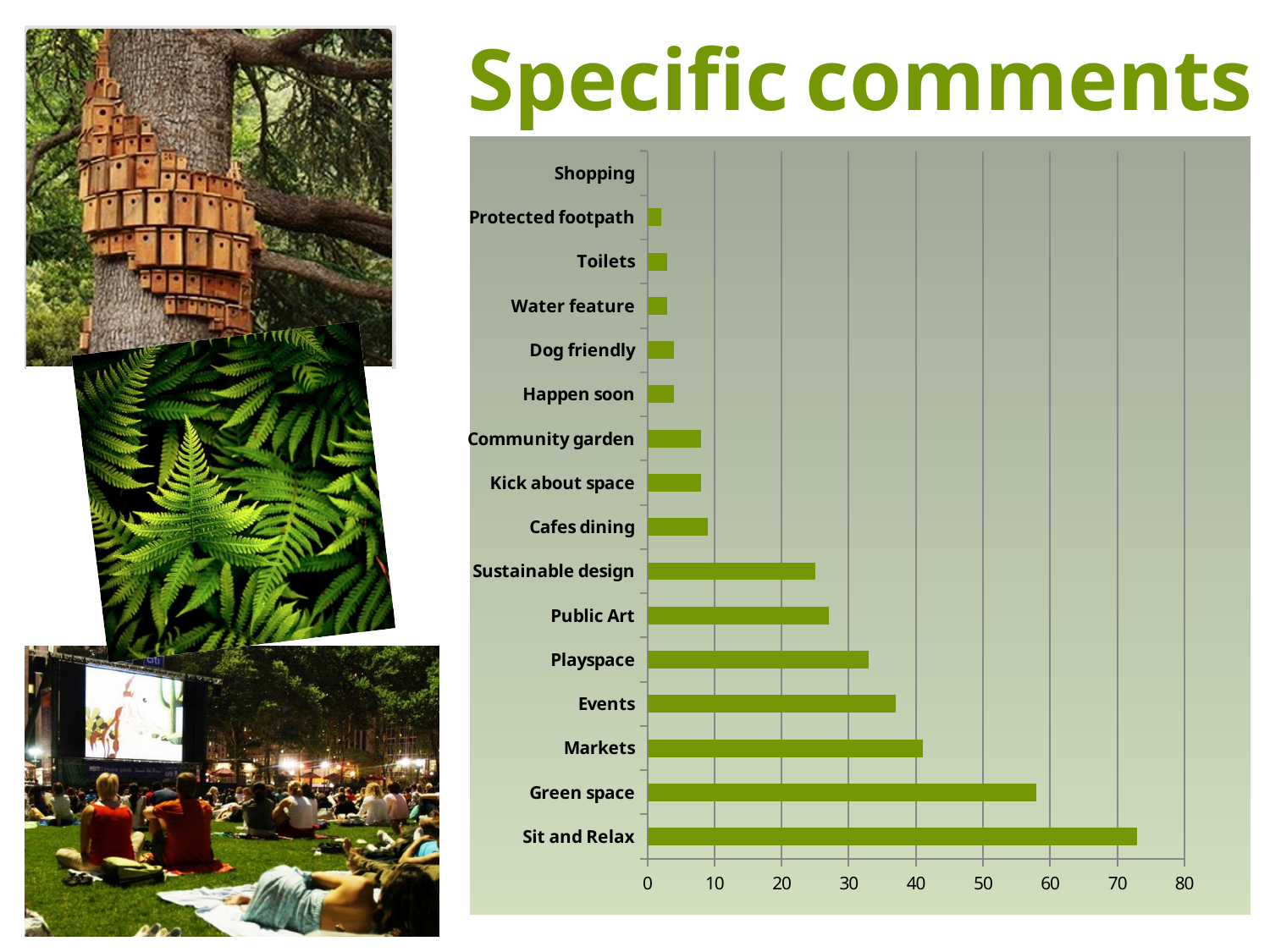
Which category has the lowest value on the chart? Shopping How many categories are listed on the chart? 16 Which has a larger value, Green space or Markets? Green space What is the title of the slide containing the chart? Specific comments Is the value for Public Art greater or less than 30? less Is the value for Sit and Relax greater or less than 70? greater Is the value for Events greater or less than 40? less What kind of chart is shown on the slide? Bar chart Which category has the highest value on the chart? Sit and Relax